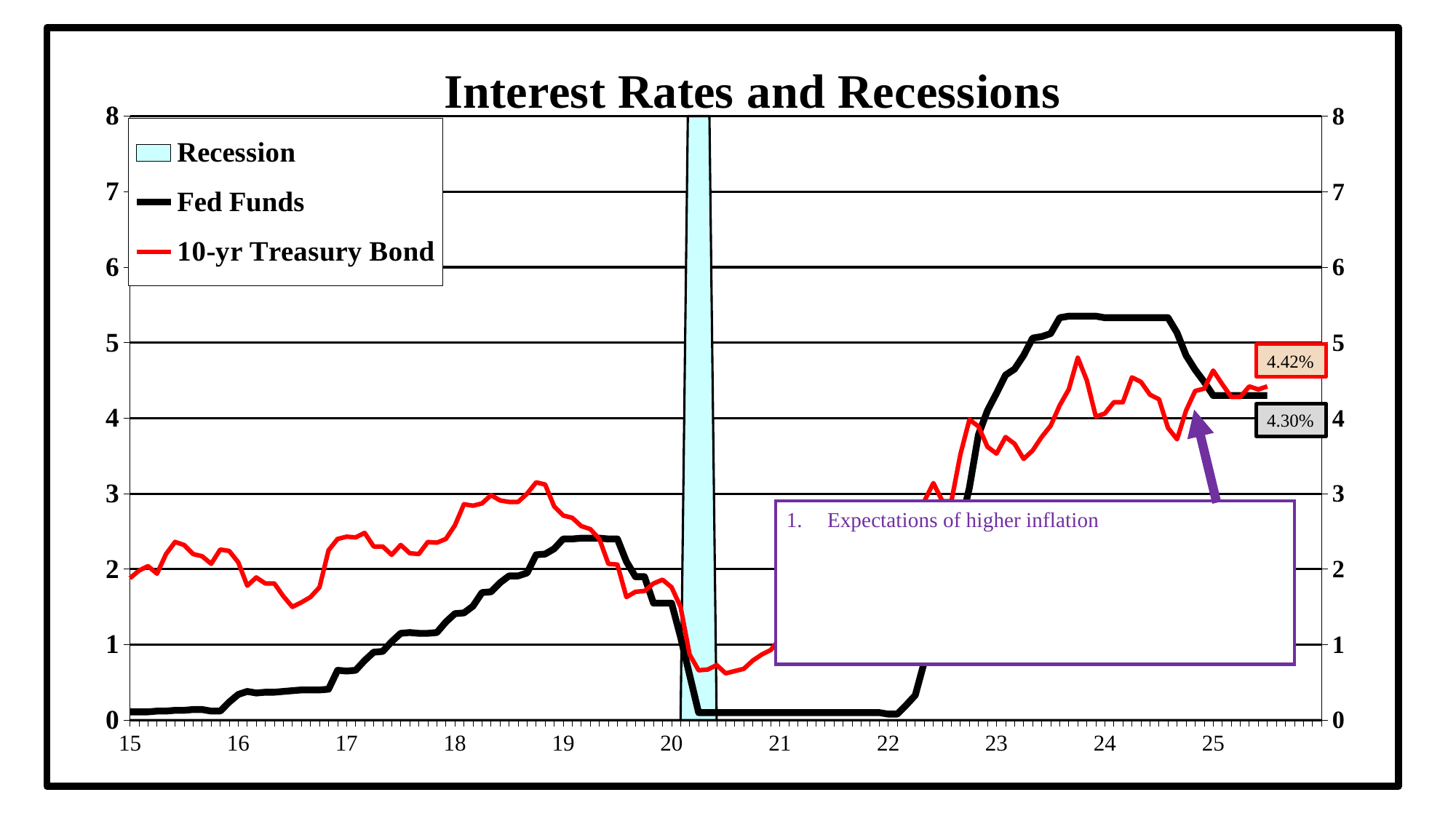
How many entries does the legend list? 3 Is the Fed Funds rate in 2021 greater or less than 1? less What is the title of the chart? Interest Rates and Recessions Which series reaches the higher peak over the whole chart, Fed Funds or the 10-yr Treasury Bond? Fed Funds Is the Fed Funds rate at the start of 2019 greater or less than 2? greater What is the difference between the labelled 10-yr Treasury Bond value (4.42%) and the labelled Fed Funds value (4.30%)? 0.12% What kind of chart is shown on the slide? line chart What is the latest value shown for Fed Funds? 4.30% Does the Fed Funds rate rise or fall between 2015 and 2019? rise What is the latest value shown for the 10-yr Treasury Bond? 4.42% At the end of the chart, which is higher: the 10-yr Treasury Bond or Fed Funds? 10-yr Treasury Bond